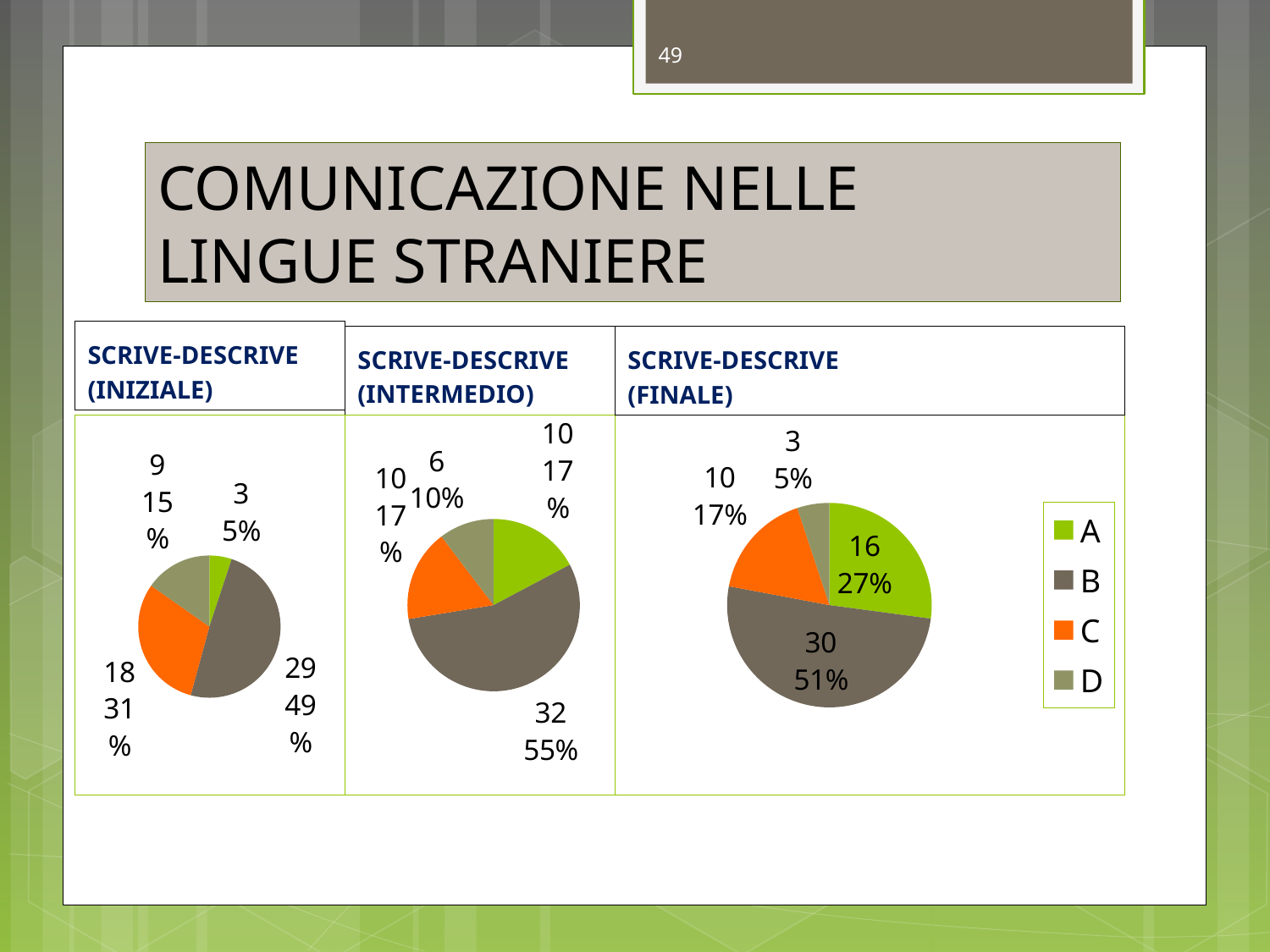
In the SCRIVE-DESCRIVE (INIZIALE) chart, what is the value for B? 29 In the SCRIVE-DESCRIVE (INTERMEDIO) chart, which category has the largest slice? B In the SCRIVE-DESCRIVE (INTERMEDIO) chart, what is the value for B? 32 In the SCRIVE-DESCRIVE (INIZIALE) chart, which category has the smallest slice? A How many categories does the legend list? 4 In the SCRIVE-DESCRIVE (INIZIALE) chart, what share of the pie does C have? 31% What kind of chart is used for SCRIVE-DESCRIVE (INIZIALE)? pie chart In the SCRIVE-DESCRIVE (FINALE) chart, which is larger, the value for C or the value for D? C In the SCRIVE-DESCRIVE (FINALE) chart, what is the value for A? 16 In the SCRIVE-DESCRIVE (INTERMEDIO) chart, what share of the pie does A have? 17% In the SCRIVE-DESCRIVE (FINALE) chart, what is the difference between the values for B and A? 14 In the SCRIVE-DESCRIVE (FINALE) chart, what share of the pie does B have? 51%